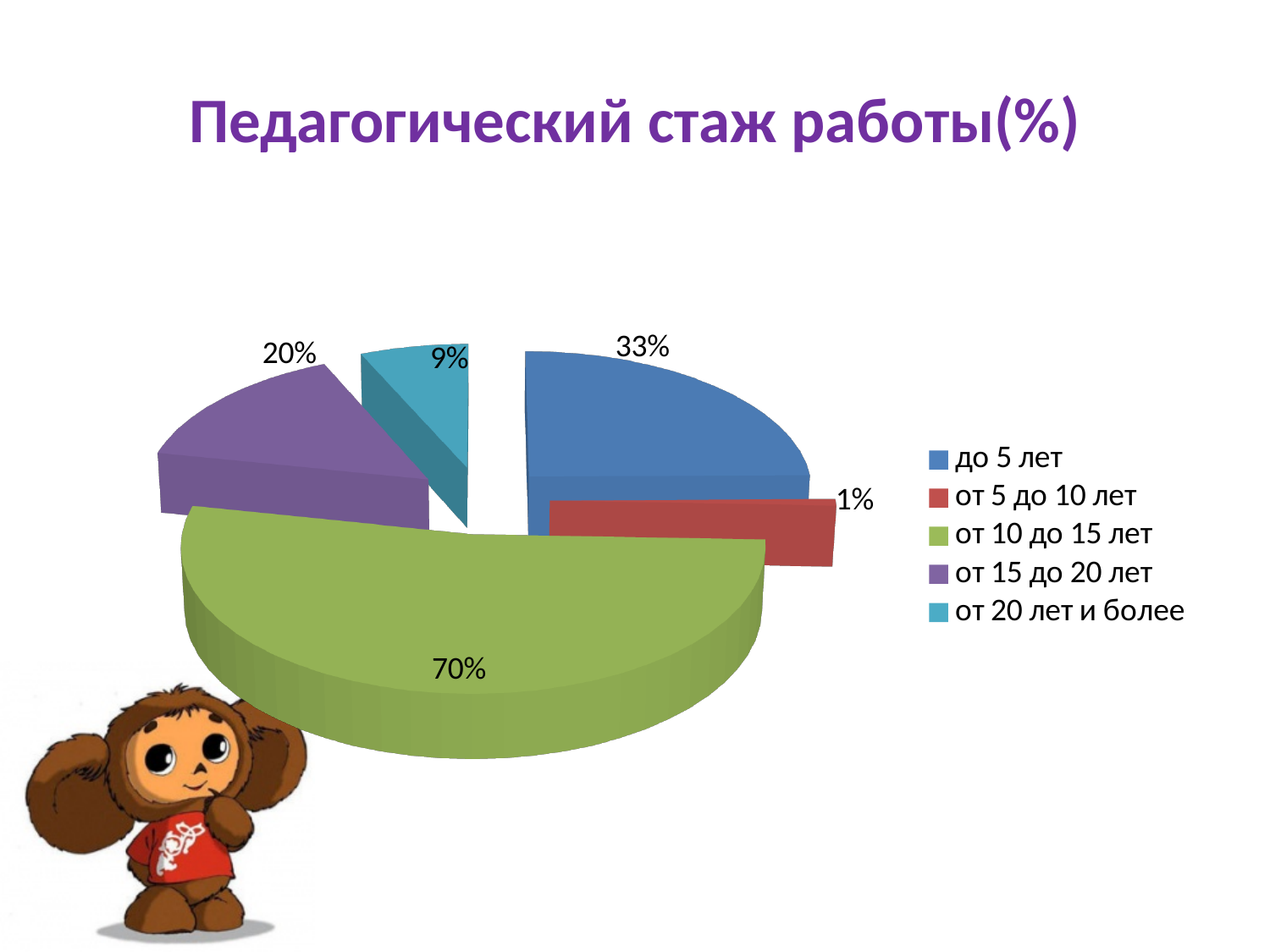
What is the value shown for "от 20 лет и более"? 9% Which is larger, the value for "до 5 лет" or the value for "от 15 до 20 лет"? до 5 лет Which category has the largest slice? от 10 до 15 лет What is the title of the chart? Педагогический стаж работы(%) How many categories does the legend list? 5 What is the value shown for "от 5 до 10 лет"? 1% What is the value shown for "от 15 до 20 лет"? 20% What kind of chart is shown on the slide? Pie chart What colour is the slice for "от 20 лет и более"? Teal (light blue) Which category has the smallest slice? от 5 до 10 лет What is the value shown for "до 5 лет"? 33% What is the value shown for "от 10 до 15 лет"? 70%